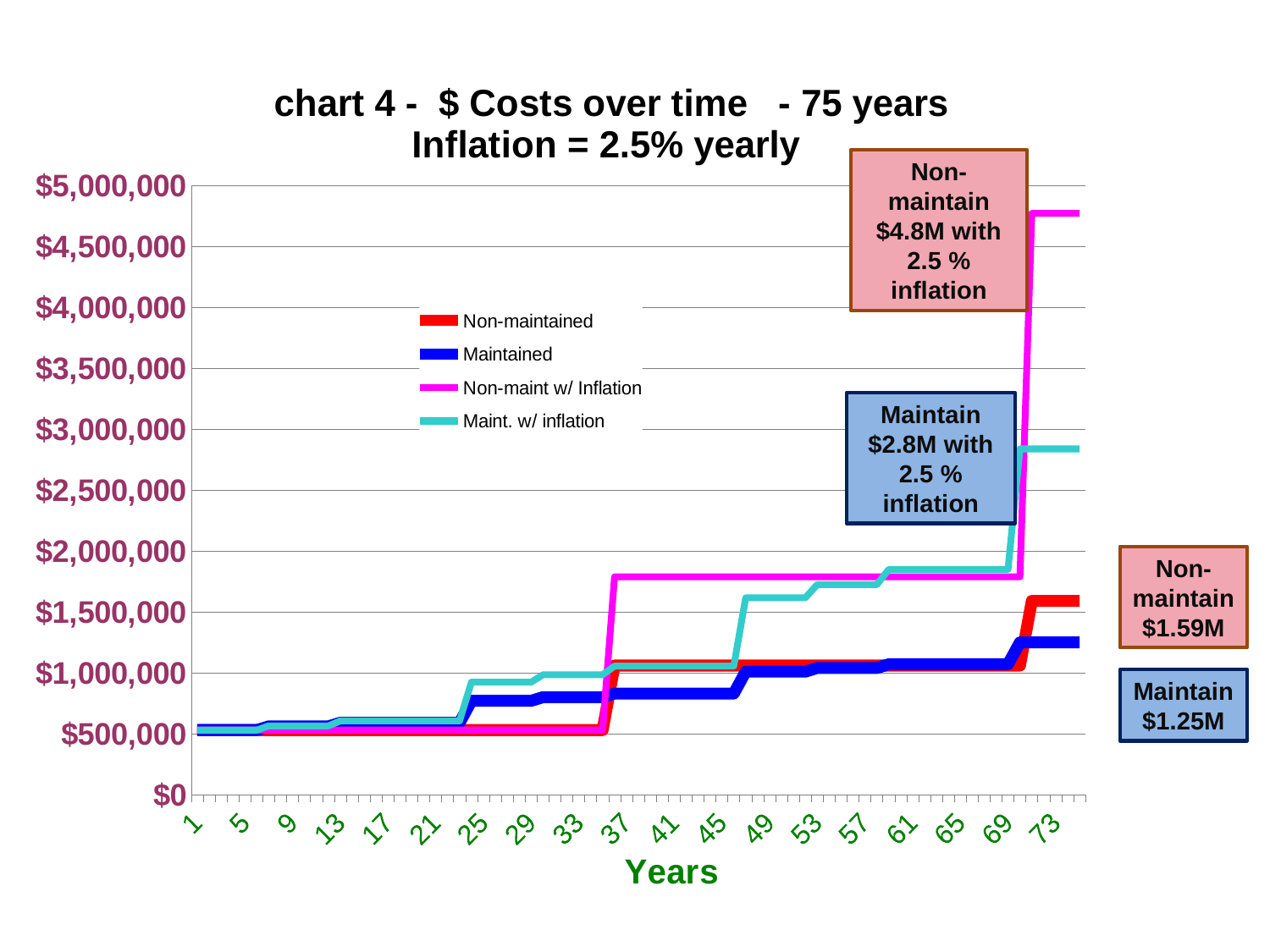
What is the difference between the final Non-maintain cost with 2.5% inflation ($4.8M) and the final Maintain cost with 2.5% inflation ($2.8M)? $2.0M According to the callout box, what is the final cost for Non-maintain with 2.5% inflation? $4.8M According to the callout box, what is the final cost for Maintain (without inflation)? $1.25M At year 41, which is larger: Non-maint w/ Inflation or Maint. w/ inflation? Non-maint w/ Inflation Is the value of the Non-maint w/ Inflation line at year 73 greater or less than $4,500,000? greater According to the callout box, what is the final cost for Maintain with 2.5% inflation? $2.8M How many series does the legend list? 4 Which series has the lowest value at the end of the 75 years? Maintained Which series reaches the highest value at the end of the 75 years? Non-maint w/ Inflation What kind of chart is shown on the slide? line chart According to the callout box, what is the final cost for Non-maintain (without inflation)? $1.59M What are the four series listed in the legend? Non-maintained, Maintained, Non-maint w/ Inflation, Maint. w/ inflation